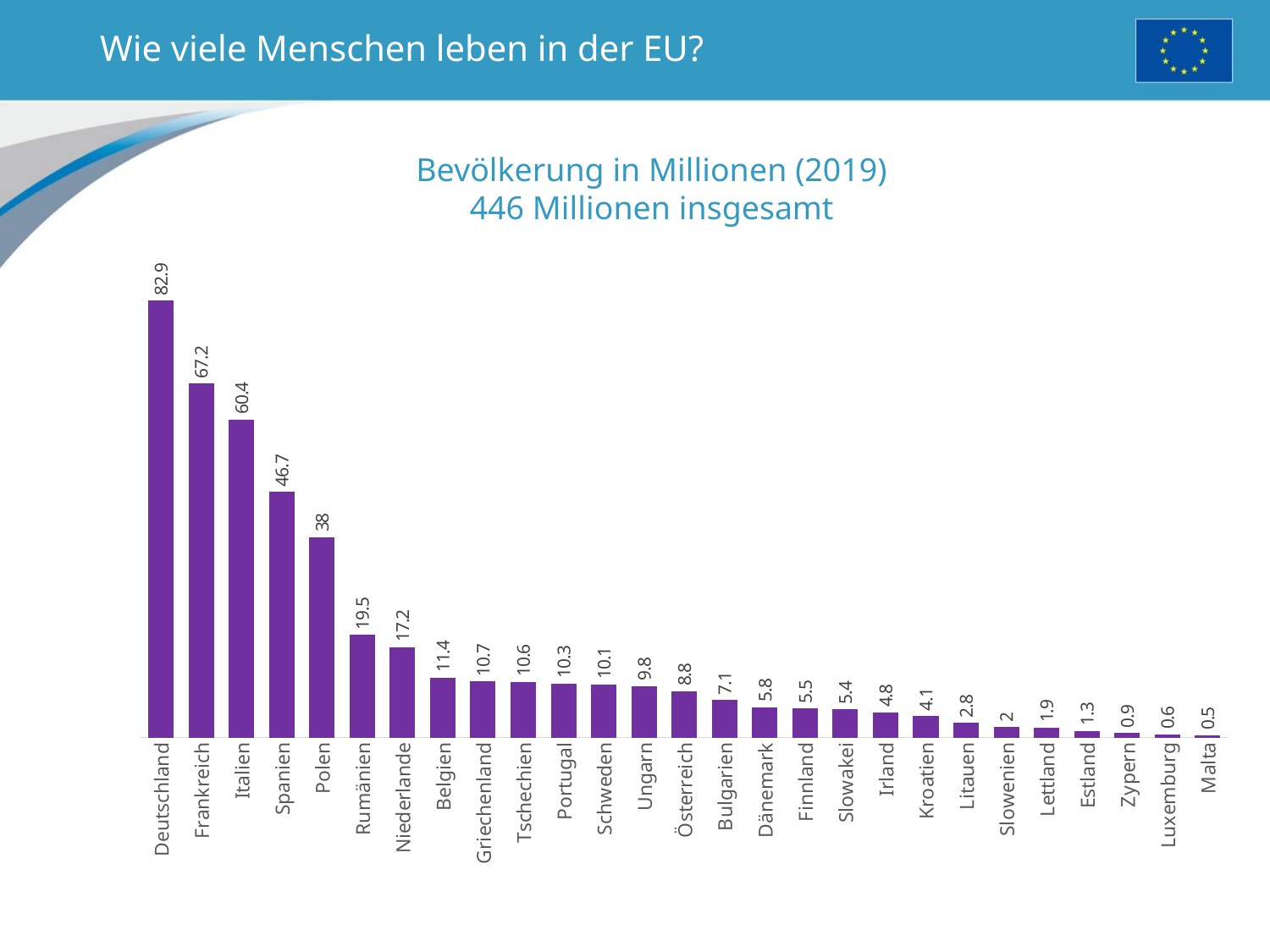
What is the difference between the values for Rumänien and Niederlande? 2.3 What is the title of the chart? Bevölkerung in Millionen (2019) 446 Millionen insgesamt What is the population value shown for Slowakei? 5.4 What is the population value shown for Deutschland? 82.9 Which has a larger value, Belgien or Schweden? Belgien Which country has the highest bar in the chart? Deutschland What is the difference between the values for Frankreich and Italien? 6.8 Which country has the lowest bar in the chart? Malta What kind of chart is shown on the slide? Bar chart What is the population value shown for Polen? 38 How many countries are shown in the chart? 27 Which has a larger value, Spanien or Polen? Spanien